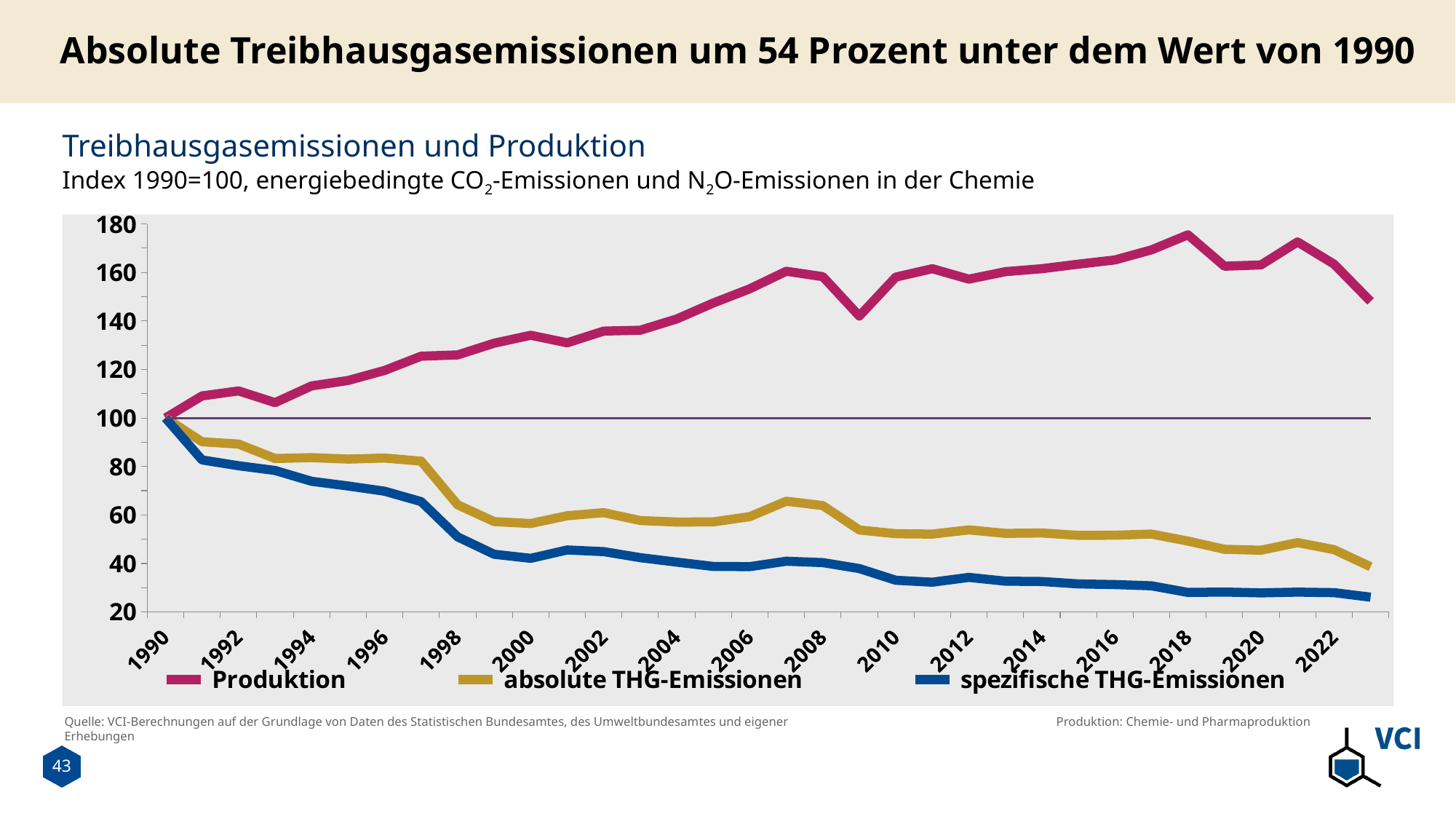
What colour is the Produktion line in the legend? magenta/pink Is the value for spezifische THG-Emissionen in 2022 greater or less than 40? less What kind of chart is shown on the slide? line chart Is the value for absolute THG-Emissionen in 2022 greater or less than 60? less In 2010, which is larger: Produktion or absolute THG-Emissionen? Produktion Is the value for Produktion in 2018 greater or less than 160? greater Which series has the highest value in 2022? Produktion How many series does the legend list? 3 In 2022, which is larger: absolute THG-Emissionen or spezifische THG-Emissionen? absolute THG-Emissionen What is the index value of Produktion in 1990? 100 Does the spezifische THG-Emissionen line rise or fall from 1990 to 2022? fall